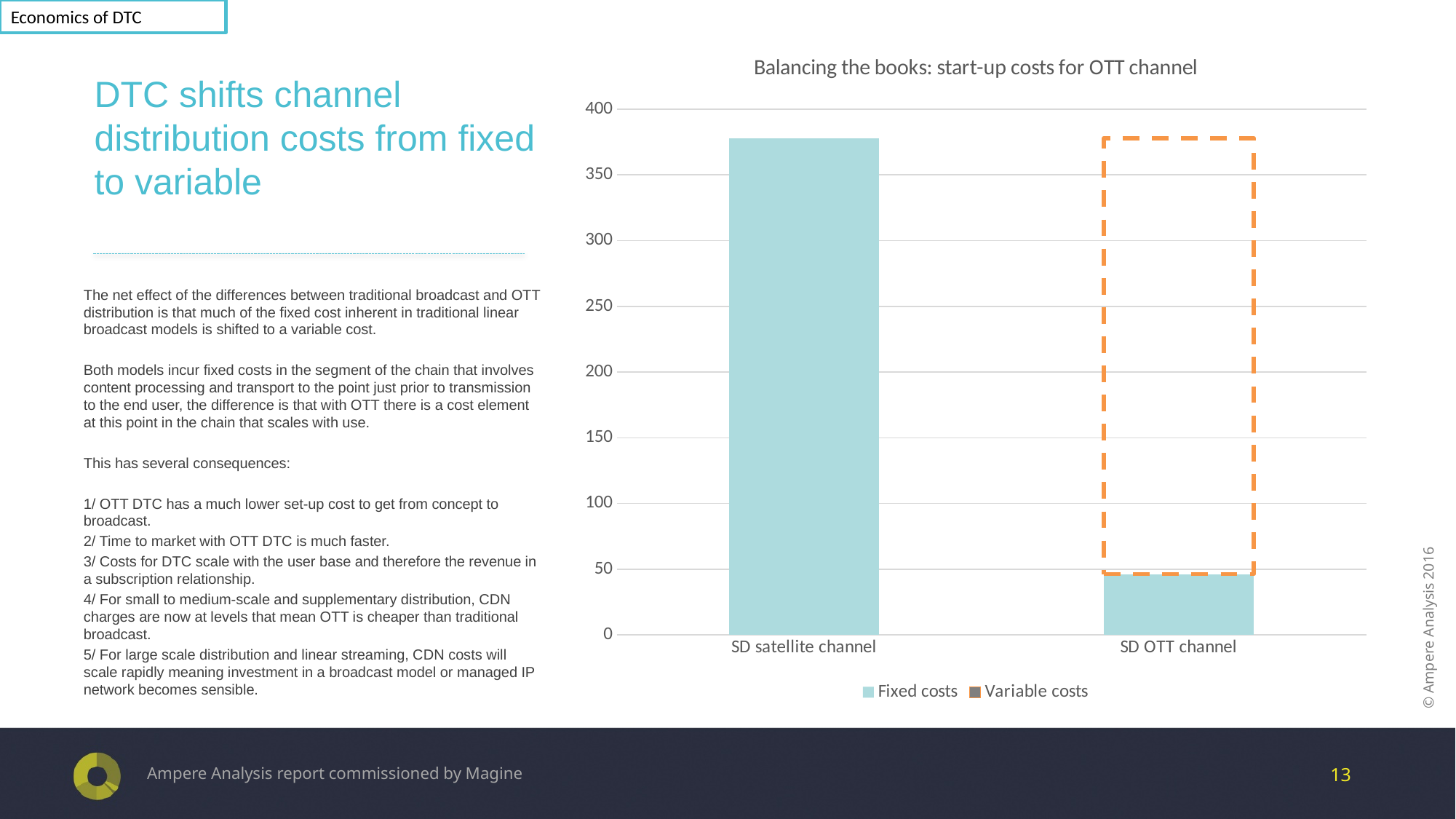
Is the fixed costs value for SD OTT channel greater or less than 100? less Which category has the higher fixed costs, SD satellite channel or SD OTT channel? SD satellite channel Is the total stacked bar for SD OTT channel greater or less than 350? greater Which category has the lowest fixed costs? SD OTT channel Is the fixed costs value for SD satellite channel greater or less than 350? greater What is the title of the chart? Balancing the books: start-up costs for OTT channel Which series are listed in the chart legend? Fixed costs and Variable costs What type of chart is shown on the slide? Bar chart Which category shows a Variable costs segment in the chart? SD OTT channel How many series does the chart legend list? 2 How many categories are shown on the x axis of the chart? 2